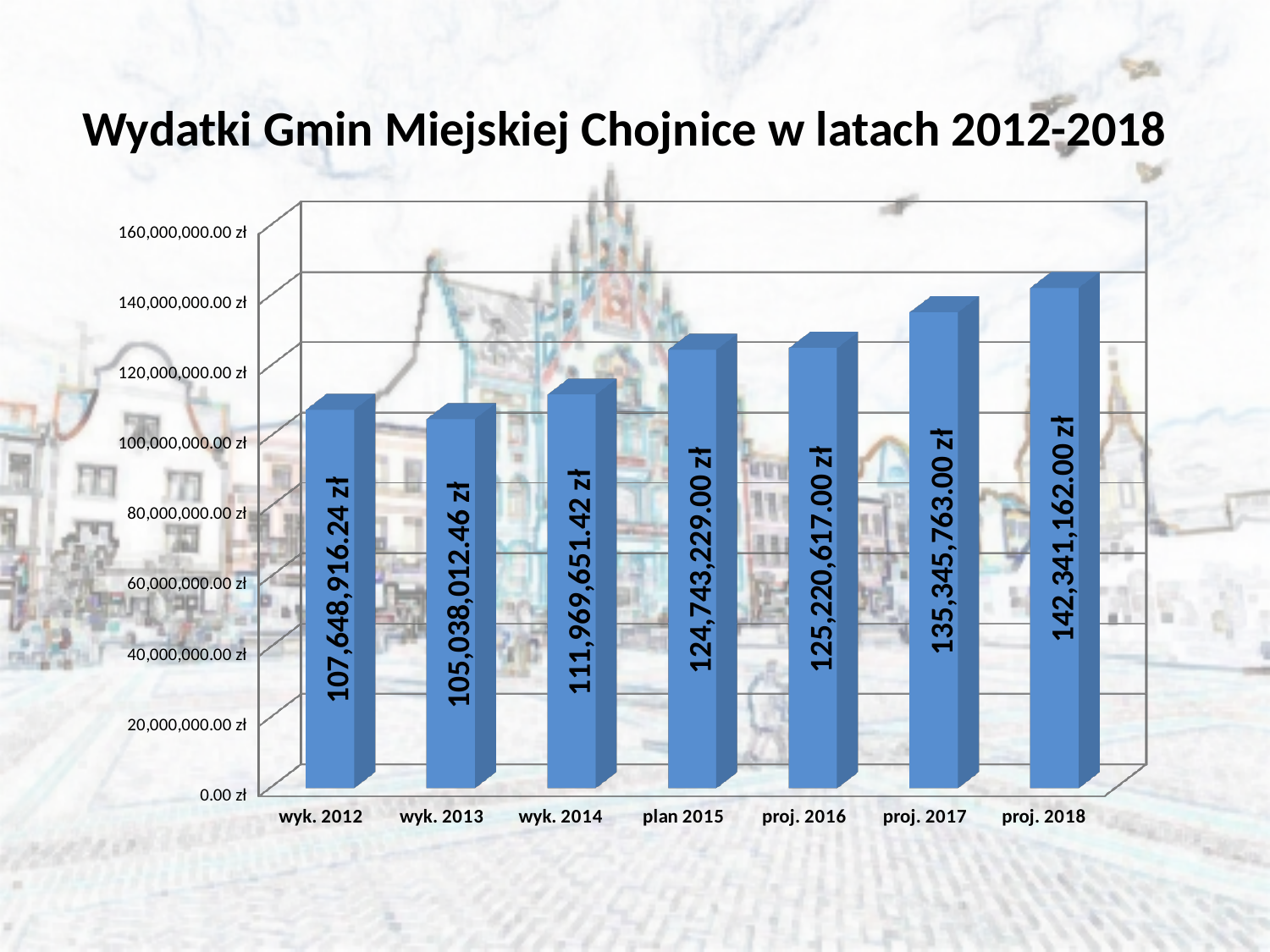
How many categories are shown on the x axis? 7 What is the value for plan 2015? 124,743,229.00 zł What is the value for wyk. 2012? 107,648,916.24 zł Which category has the highest value? proj. 2018 What is the title of the slide? Wydatki Gmin Miejskiej Chojnice w latach 2012-2018 What is the value for proj. 2017? 135,345,763.00 zł Which is larger, the value for wyk. 2012 or wyk. 2013? wyk. 2012 What kind of chart is shown on the slide? bar chart What is the difference between the values for proj. 2018 and proj. 2017? 6,995,399.00 zł Is the value for wyk. 2013 greater or less than 120,000,000.00 zł? less Which category has the lowest value? wyk. 2013 Is the value for proj. 2018 greater or less than 140,000,000.00 zł? greater